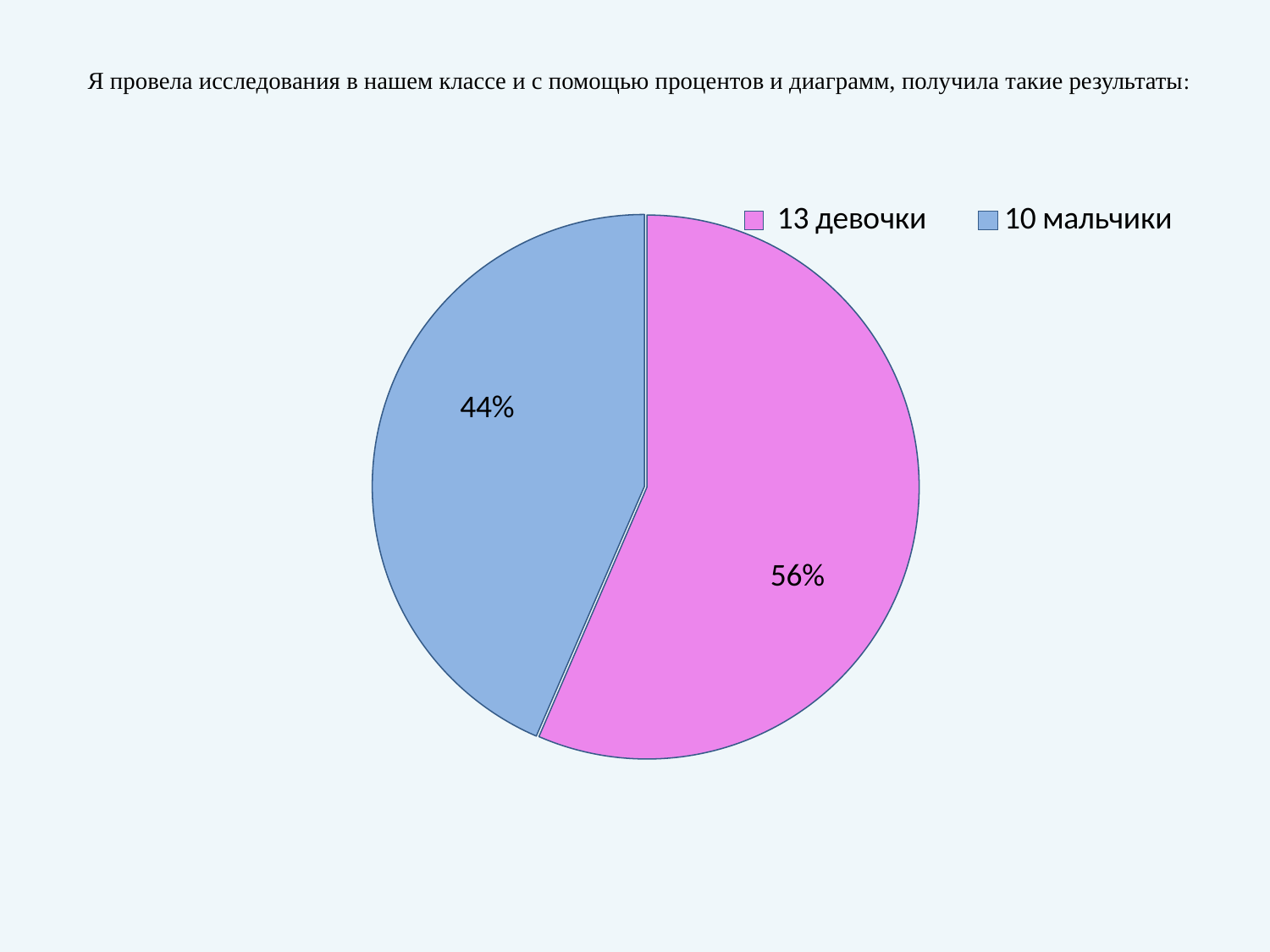
What percentage of the pie does the "10 мальчики" slice represent? 44% Is the share for "10 мальчики" greater or less than 50%? less What colour is the "10 мальчики" slice? blue Which slice is the smallest in the pie chart? 10 мальчики What colour is the "13 девочки" slice? pink Which slice is the largest in the pie chart? 13 девочки How many entries does the legend list? 2 Which slice is larger, "13 девочки" or "10 мальчики"? 13 девочки What kind of chart is shown on the slide? pie chart What is the difference in percentage points between the "13 девочки" slice and the "10 мальчики" slice? 12% What percentage of the pie does the "13 девочки" slice represent? 56% How many slices does the pie chart have? 2